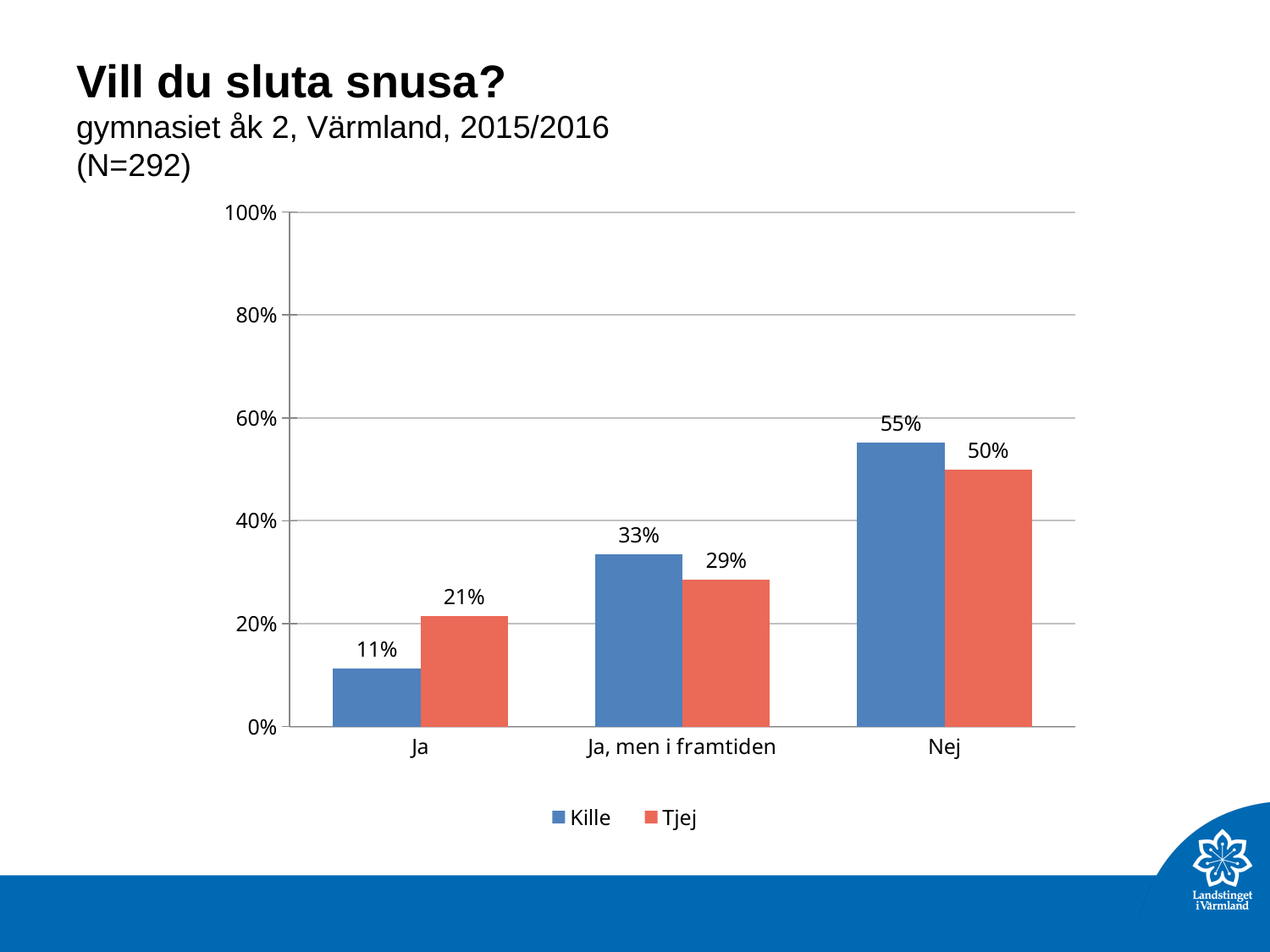
What kind of chart is shown on the slide? Bar chart How many categories are shown on the x axis? 3 How many series does the legend list? 2 What is the value for Kille in the 'Ja' category? 11% What is the value for Tjej in the 'Nej' category? 50% What is the difference between Kille and Tjej in the 'Nej' category? 5% What is the value for Tjej in the 'Ja, men i framtiden' category? 29% Is the value for Kille in the 'Nej' category greater or less than 40%? greater Which category has the lowest value for Tjej? Ja In the 'Ja, men i framtiden' category, which series has the larger value, Kille or Tjej? Kille Which category has the highest value for Kille? Nej What is the difference between Tjej and Kille in the 'Ja' category? 10%